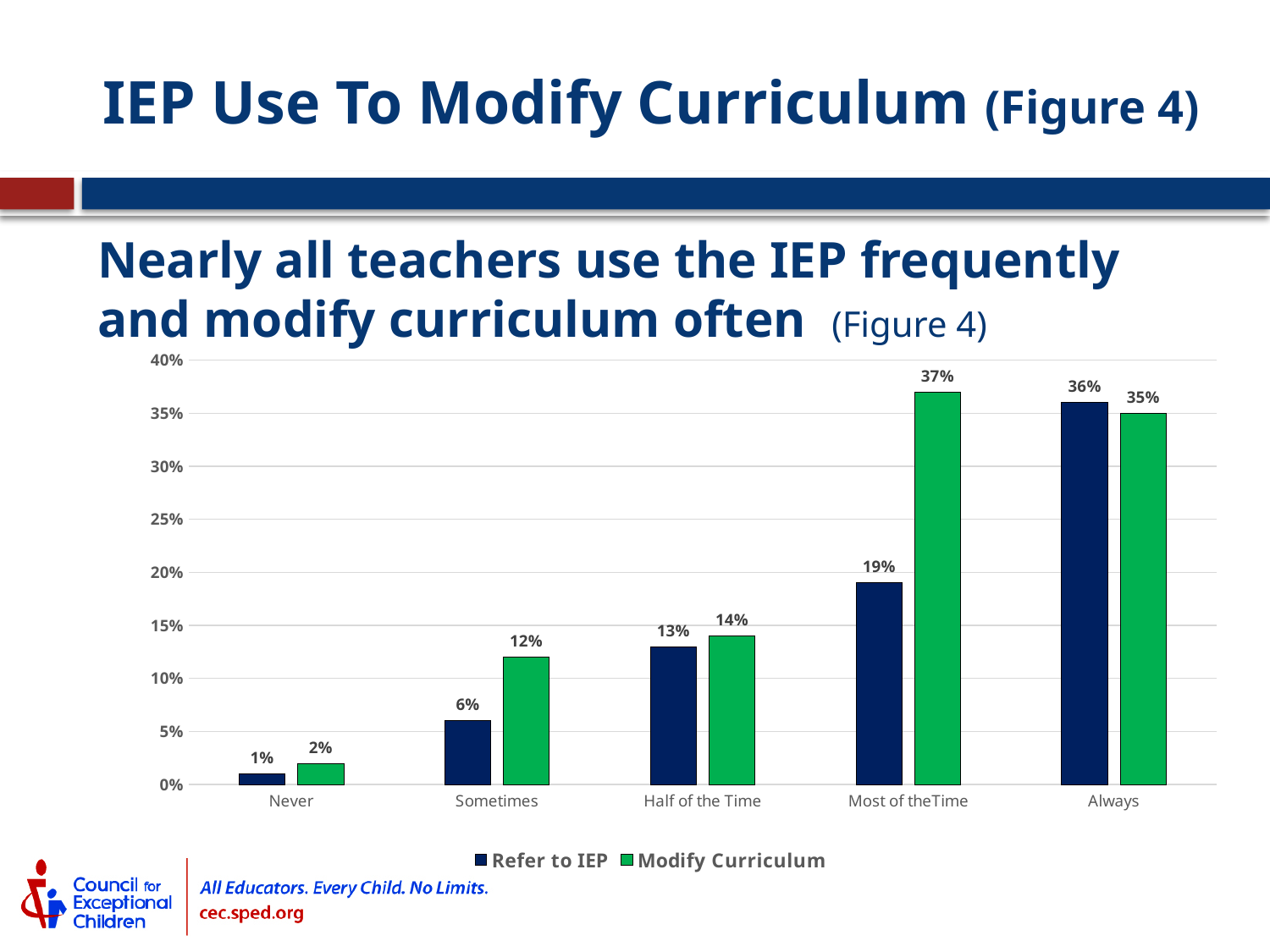
What is the difference between Modify Curriculum and Refer to IEP in the Most of the Time category? 18% How many series does the legend list? 2 Which is larger in the Always category, Refer to IEP or Modify Curriculum? Refer to IEP Which category has the highest value for Modify Curriculum? Most of the Time Which series is shown in green in the legend? Modify Curriculum Is the value for Refer to IEP in the Half of the Time category greater or less than 10%? greater What is the value for Refer to IEP in the Always category? 36% What is the value for Modify Curriculum in the Sometimes category? 12% Which category has the lowest value for Refer to IEP? Never What kind of chart is shown on the slide? Bar chart How many categories are shown on the x axis? 5 What is the value for Refer to IEP in the Most of the Time category? 19%